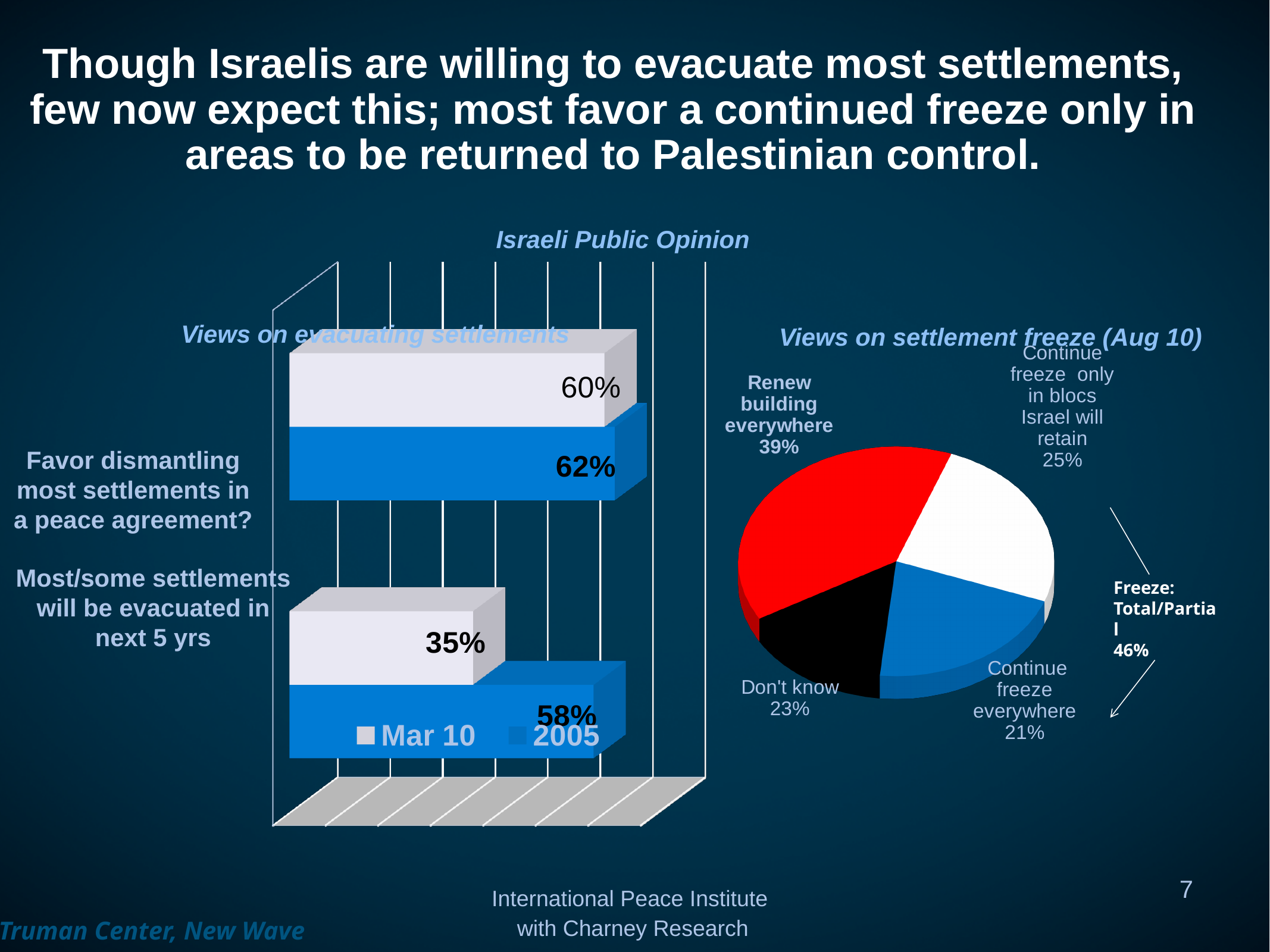
In the 'Views on settlement freeze (Aug 10)' chart, what share is 'Renew building everywhere'? 39% In the 'Views on evacuating settlements' chart, what is the Mar 10 value for 'Most/some settlements will be evacuated in next 5 yrs'? 35% In the 'Views on evacuating settlements' chart, what is the 2005 value for 'Most/some settlements will be evacuated in next 5 yrs'? 58% In the 'Views on settlement freeze (Aug 10)' chart, which slice is the largest? Renew building everywhere In the 'Views on evacuating settlements' chart, which series has the larger value for 'Favor dismantling most settlements in a peace agreement?', Mar 10 or 2005? 2005 How many slices does the 'Views on settlement freeze (Aug 10)' pie chart have? 4 In the 'Views on settlement freeze (Aug 10)' chart, what share is 'Continue freeze everywhere'? 21% In the 'Views on evacuating settlements' chart, how many series does the legend list? 2 In the 'Views on evacuating settlements' chart, what is the difference between the 2005 and Mar 10 values for 'Most/some settlements will be evacuated in next 5 yrs'? 23% What kind of chart is 'Views on evacuating settlements'? Bar chart In the 'Views on evacuating settlements' chart, what is the Mar 10 value for 'Favor dismantling most settlements in a peace agreement?' 60%